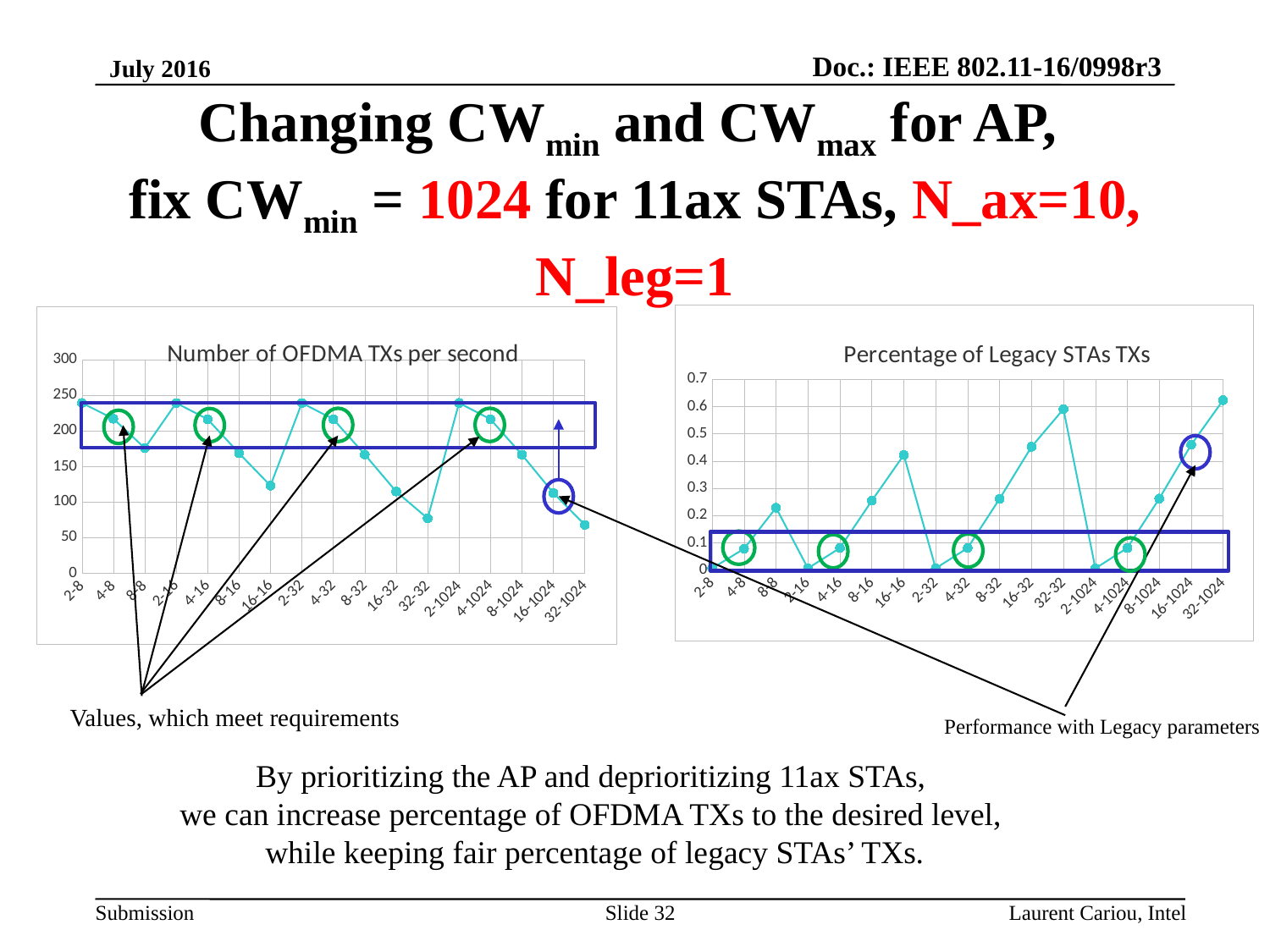
What kind of chart is the 'Number of OFDMA TXs per second' chart on the left? line chart In the 'Number of OFDMA TXs per second' chart, which is larger, the value for 2-8 or the value for 32-32? 2-8 In the 'Percentage of Legacy STAs TXs' chart, is the value for 16-32 greater or less than 0.4? greater In the 'Number of OFDMA TXs per second' chart, is the value for 2-8 greater or less than 200? greater What is the title of the chart on the right side of the slide? Percentage of Legacy STAs TXs In the 'Number of OFDMA TXs per second' chart, is the value for 16-16 greater or less than 150? less How many categories are plotted along the x axis of the 'Number of OFDMA TXs per second' chart? 17 In the 'Percentage of Legacy STAs TXs' chart, which is larger, the value for 32-32 or the value for 8-8? 32-32 How many categories are plotted along the x axis of the 'Percentage of Legacy STAs TXs' chart? 17 What kind of chart is the 'Percentage of Legacy STAs TXs' chart on the right? line chart